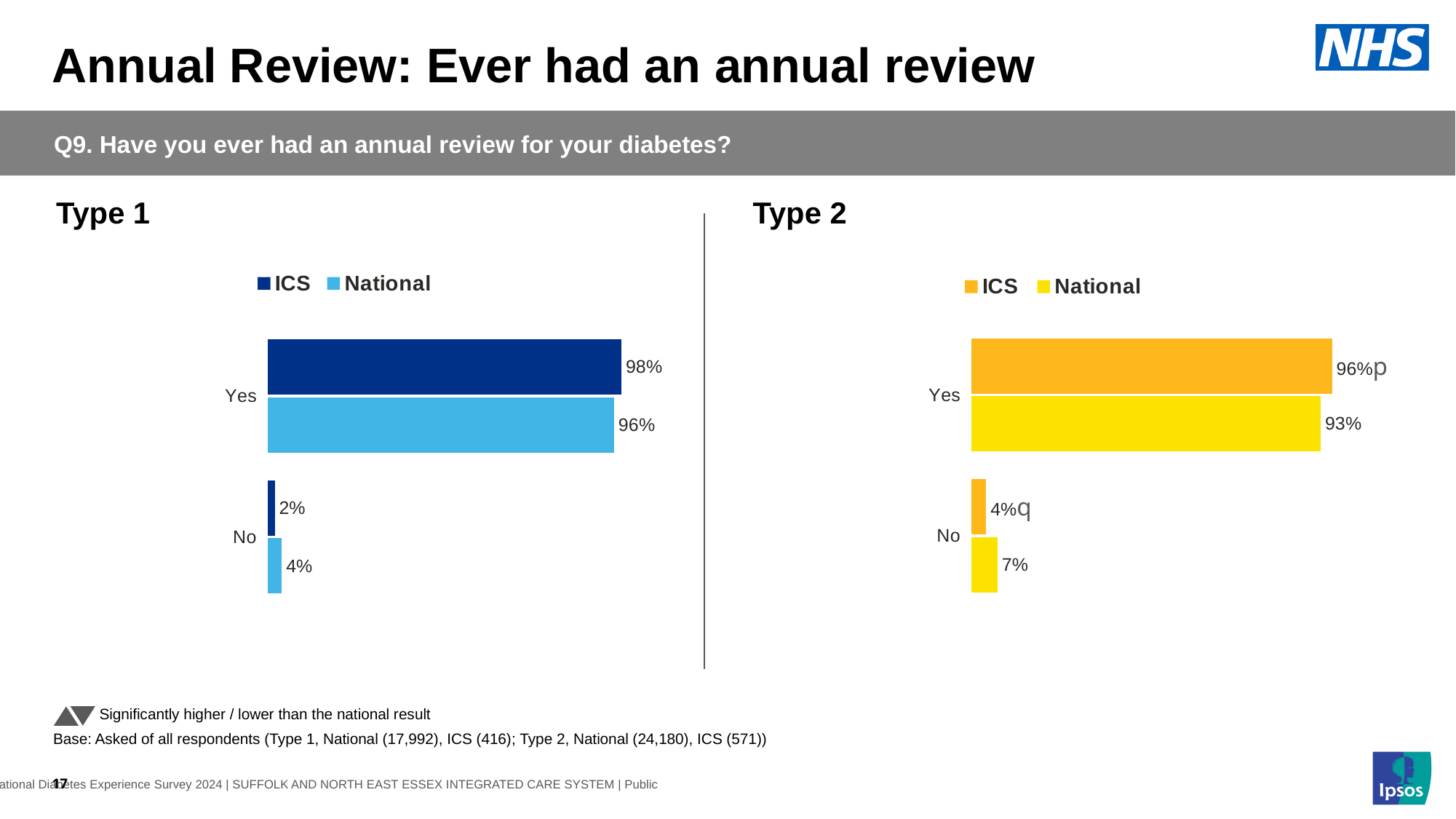
In the Type 2 chart, which is larger for Yes, ICS or National? ICS In the Type 2 chart, what is the National value for Yes? 93% In the Type 1 chart, what is the difference between the ICS and National values for Yes? 2% In the Type 2 chart, what colour are the ICS bars? Orange In the Type 1 chart, what is the National value for No? 4% In the Type 2 chart, what is the difference between the National and ICS values for No? 3% In the Type 1 chart, which is larger for No, ICS or National? National How many series does the legend of the Type 1 chart list? 2 In the Type 2 chart, what is the ICS value for No? 4% What kind of chart is the Type 1 chart? Bar chart In the Type 1 chart, what is the ICS value for Yes? 98% How many categories are shown in the Type 2 chart? 2